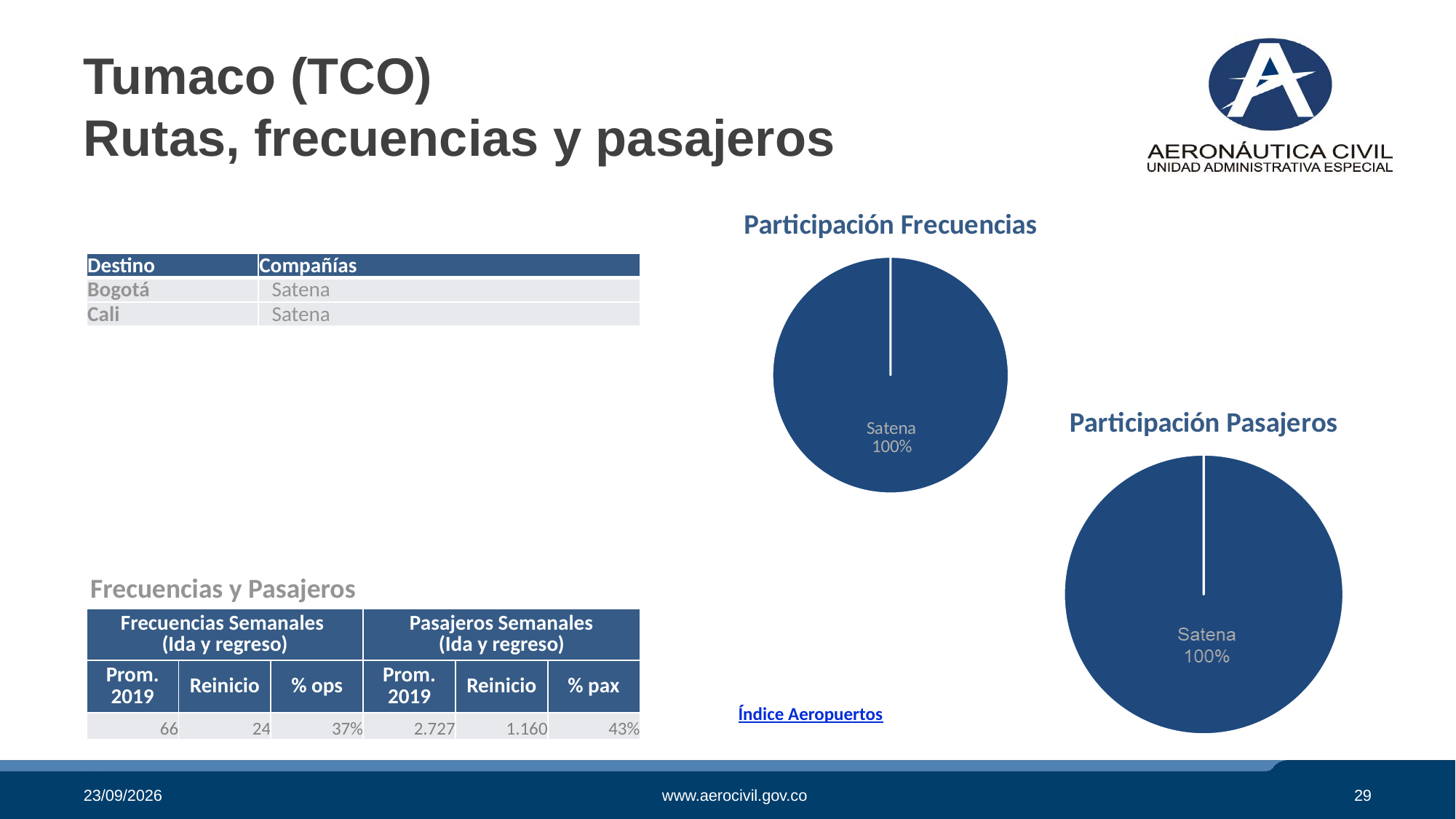
What kind of chart is 'Participación Pasajeros'? Pie chart What kind of chart is 'Participación Frecuencias'? Pie chart How many pie charts are on the slide? 2 How many slices does the 'Participación Pasajeros' pie chart have? 1 What is the title of the pie chart on the upper right of the slide? Participación Frecuencias In the 'Participación Pasajeros' chart, what share does Satena hold? 100% Which company is shown in the 'Participación Frecuencias' pie chart? Satena What is the title of the pie chart on the lower right of the slide? Participación Pasajeros How many slices does the 'Participación Frecuencias' pie chart have? 1 In the 'Participación Frecuencias' chart, what share does Satena hold? 100% Which company is shown in the 'Participación Pasajeros' pie chart? Satena